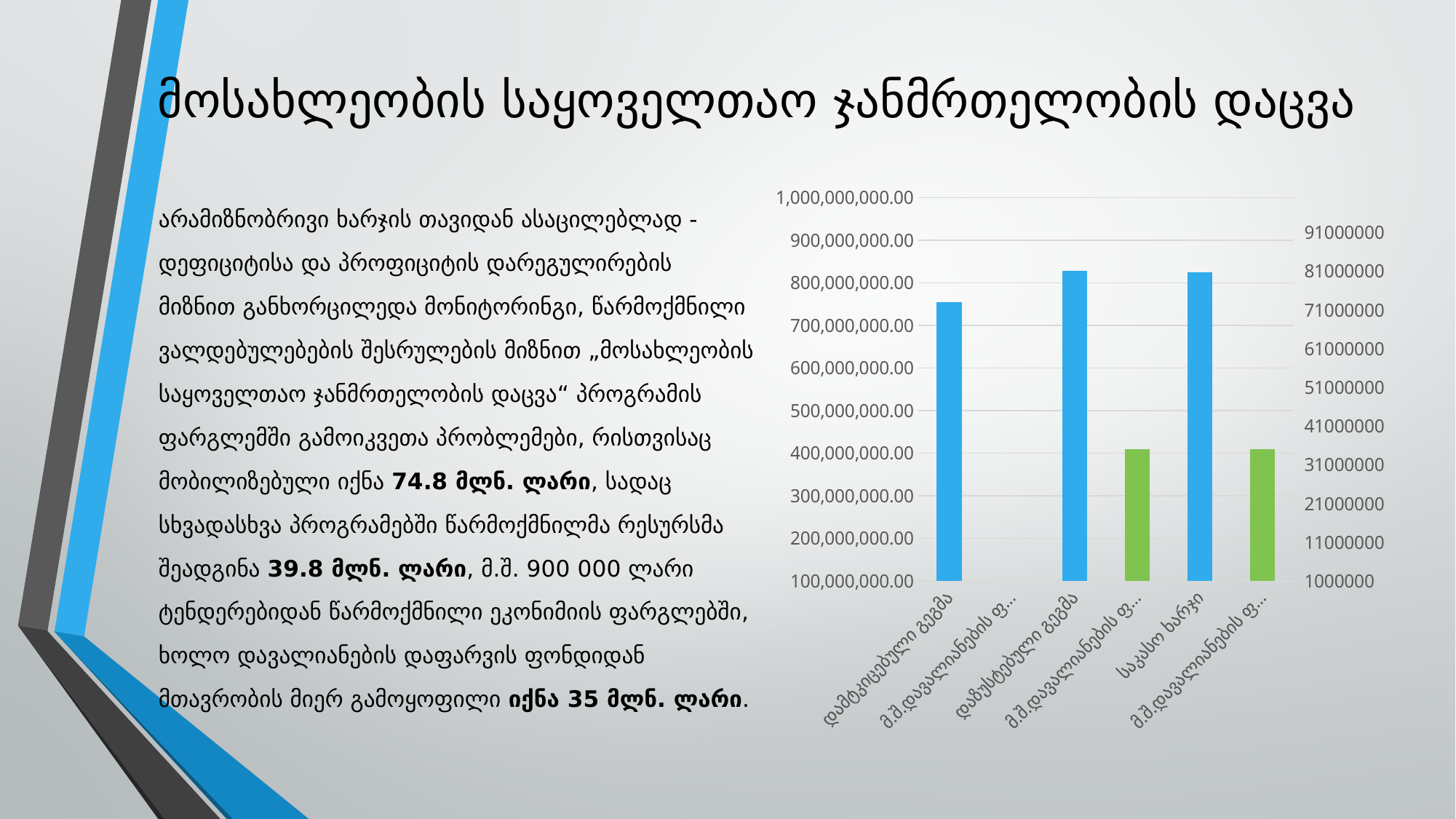
Is the value for დამტკიცებული გეგმა greater or less than 700,000,000.00 on the left axis? greater How many categories are labelled on the x axis of the chart? 6 Among the blue bars, which category has the lowest value? დამტკიცებული გეგმა What kind of chart is shown on the slide? bar chart Is the value for დამტკიცებული გეგმა greater or less than 800,000,000.00 on the left axis? less Is the value for დაზუსტებული გეგმა greater or less than 800,000,000.00 on the left axis? greater What is the highest tick value shown on the left vertical axis? 1,000,000,000.00 What is the highest tick value shown on the right vertical axis? 91000000 Which is larger, the value for დამტკიცებული გეგმა or the value for დაზუსტებული გეგმა? დაზუსტებული გეგმა